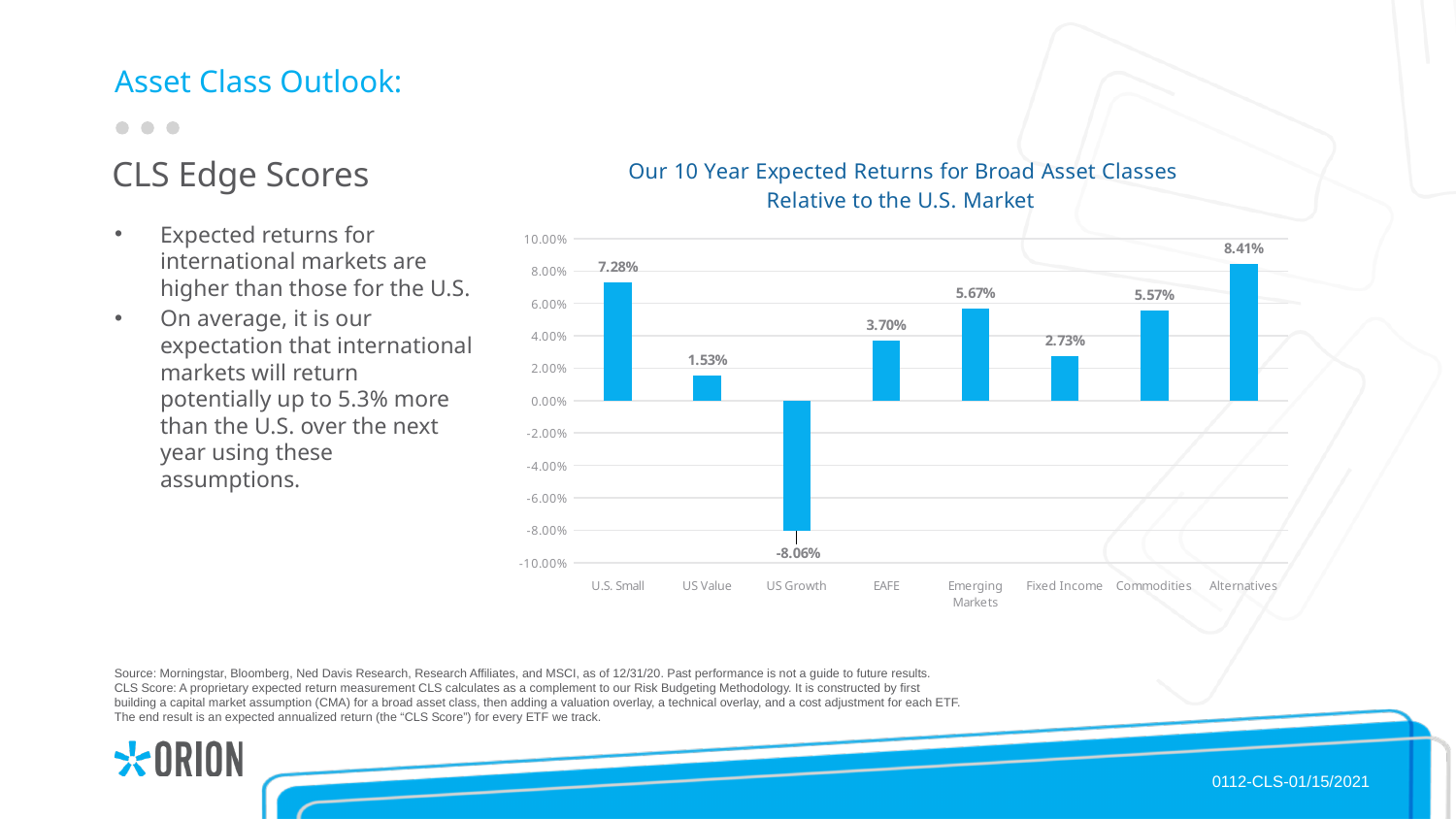
How many asset classes are shown on the x axis? 8 What is the title of the chart? Our 10 Year Expected Returns for Broad Asset Classes Relative to the U.S. Market Which asset class has the lowest expected return? US Growth What is the value for US Growth? -8.06% What kind of chart is shown on the slide? Bar chart What is the difference between the values for Alternatives and U.S. Small? 1.13% Which is larger, the value for US Value or the value for Fixed Income? Fixed Income What is the difference between the values for Emerging Markets and EAFE? 1.97% What is the value for Fixed Income? 2.73% Which asset class has the highest expected return? Alternatives Which is larger, the value for Emerging Markets or the value for Commodities? Emerging Markets What is the value for U.S. Small? 7.28%